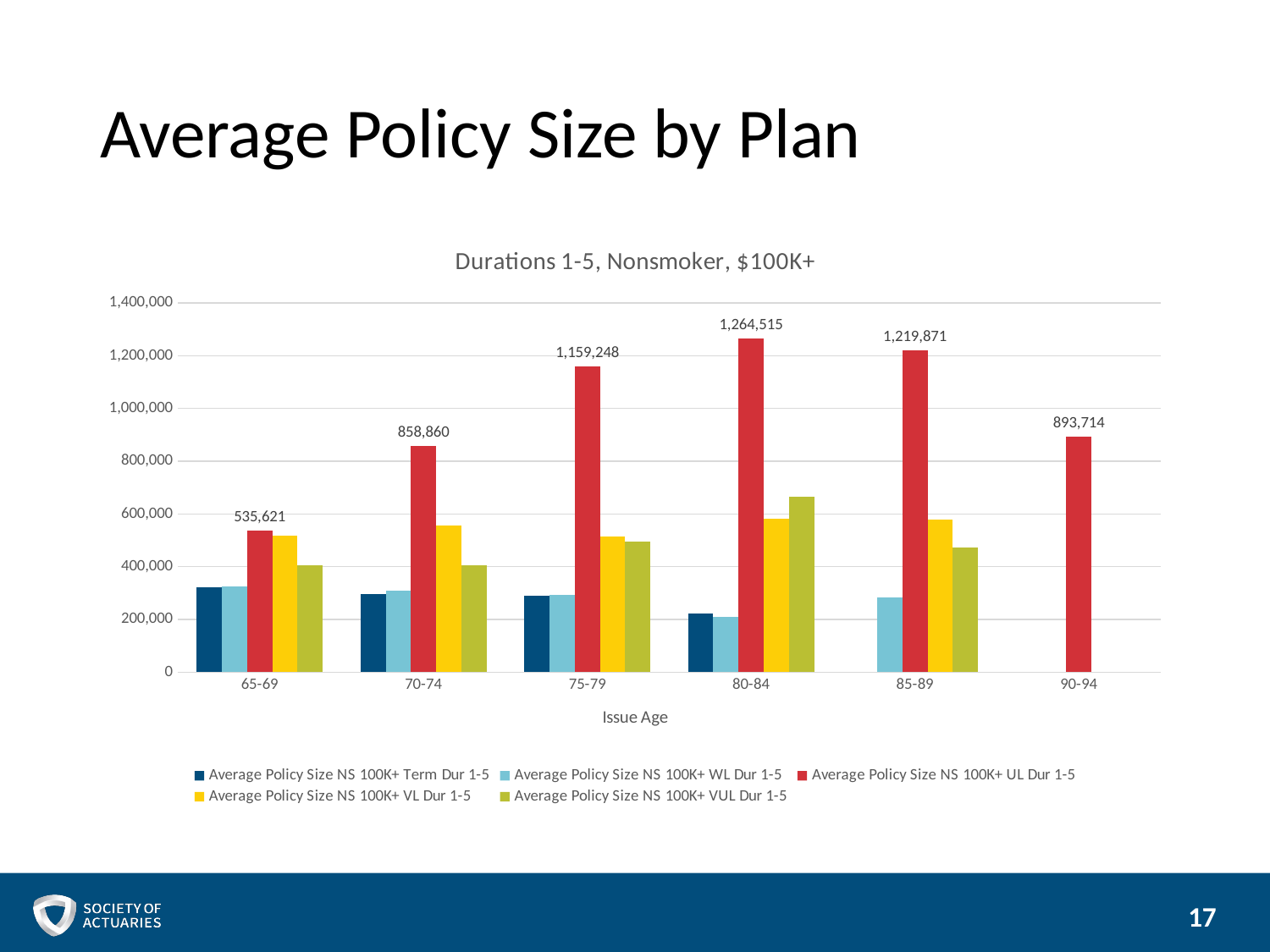
How many issue age categories are shown on the x axis? 6 Is the value for the Average Policy Size NS 100K+ VUL Dur 1-5 series at issue age 80-84 greater or less than 600,000? greater How many series does the legend list? 5 Which issue age has the lowest value for the Average Policy Size NS 100K+ UL Dur 1-5 series? 65-69 Which issue age has the highest value for the Average Policy Size NS 100K+ UL Dur 1-5 series? 80-84 What is the value of the Average Policy Size NS 100K+ UL Dur 1-5 series for issue age 90-94? 893,714 Is the value for the Average Policy Size NS 100K+ Term Dur 1-5 series at issue age 65-69 greater or less than 400,000? less What is the difference between the UL Dur 1-5 values for issue ages 80-84 and 85-89? 44,644 What is the value of the Average Policy Size NS 100K+ UL Dur 1-5 series for issue age 80-84? 1,264,515 What is the value of the Average Policy Size NS 100K+ UL Dur 1-5 series for issue age 65-69? 535,621 Which is larger for the UL Dur 1-5 series: the value for issue age 70-74 or for issue age 90-94? 90-94 What type of chart is shown on the slide? Bar chart